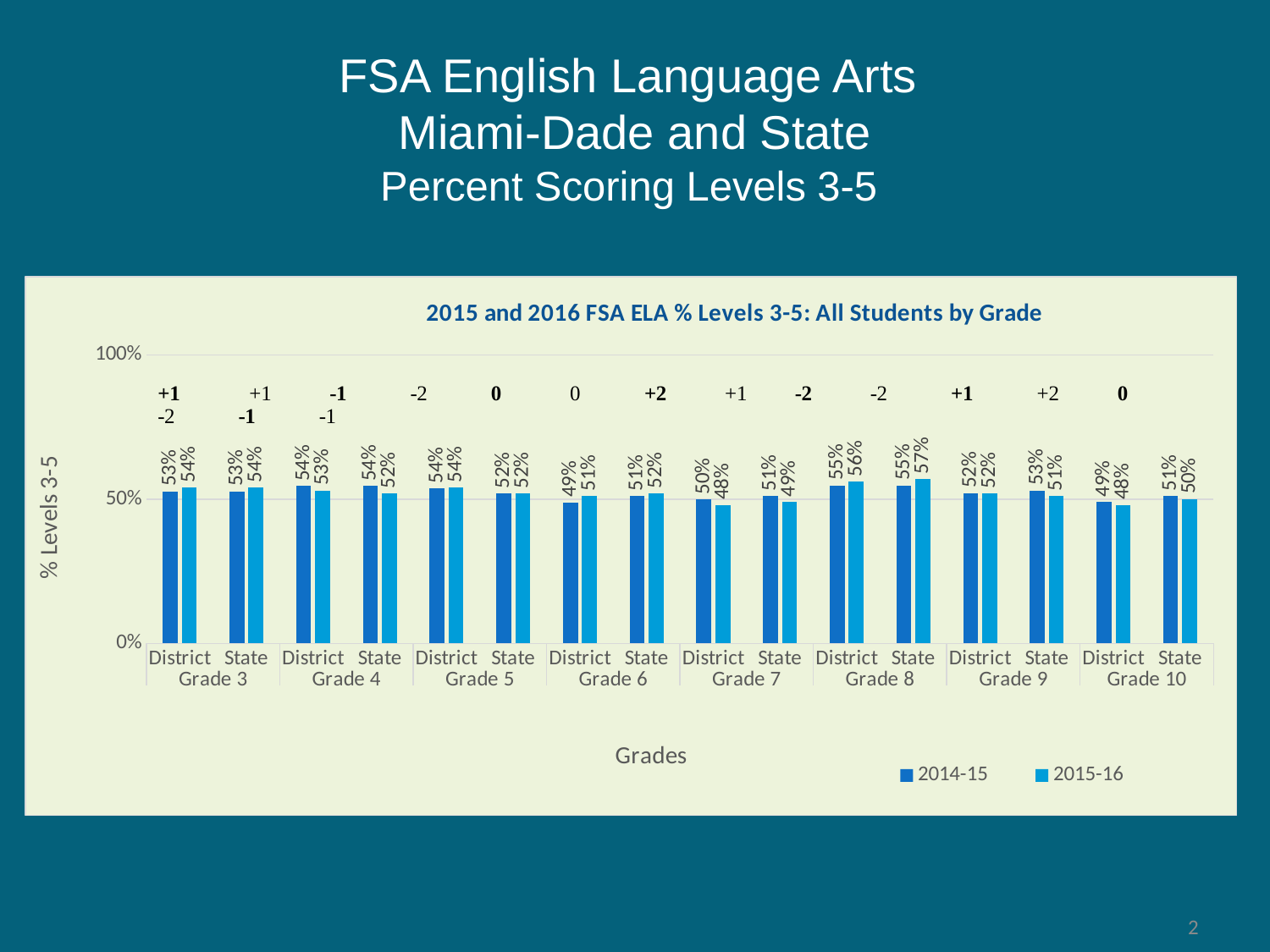
What is the 2014-15 value for District Grade 6? 49% What is the difference between the 2014-15 and 2015-16 values for State Grade 4? 2% What is the 2015-16 value for State Grade 8? 57% Which category has the highest 2015-16 value? State Grade 8 What is the 2014-15 value for State Grade 10? 51% What is the 2015-16 value for District Grade 7? 48% What type of chart is shown on the slide? Bar chart What is the label on the y axis? % Levels 3-5 What is the title of the chart? 2015 and 2016 FSA ELA % Levels 3-5: All Students by Grade How many category groups (District/State bars) are shown along the x axis? 16 How many series does the legend list? 2 Which is larger for District Grade 6: the 2014-15 value or the 2015-16 value? 2015-16